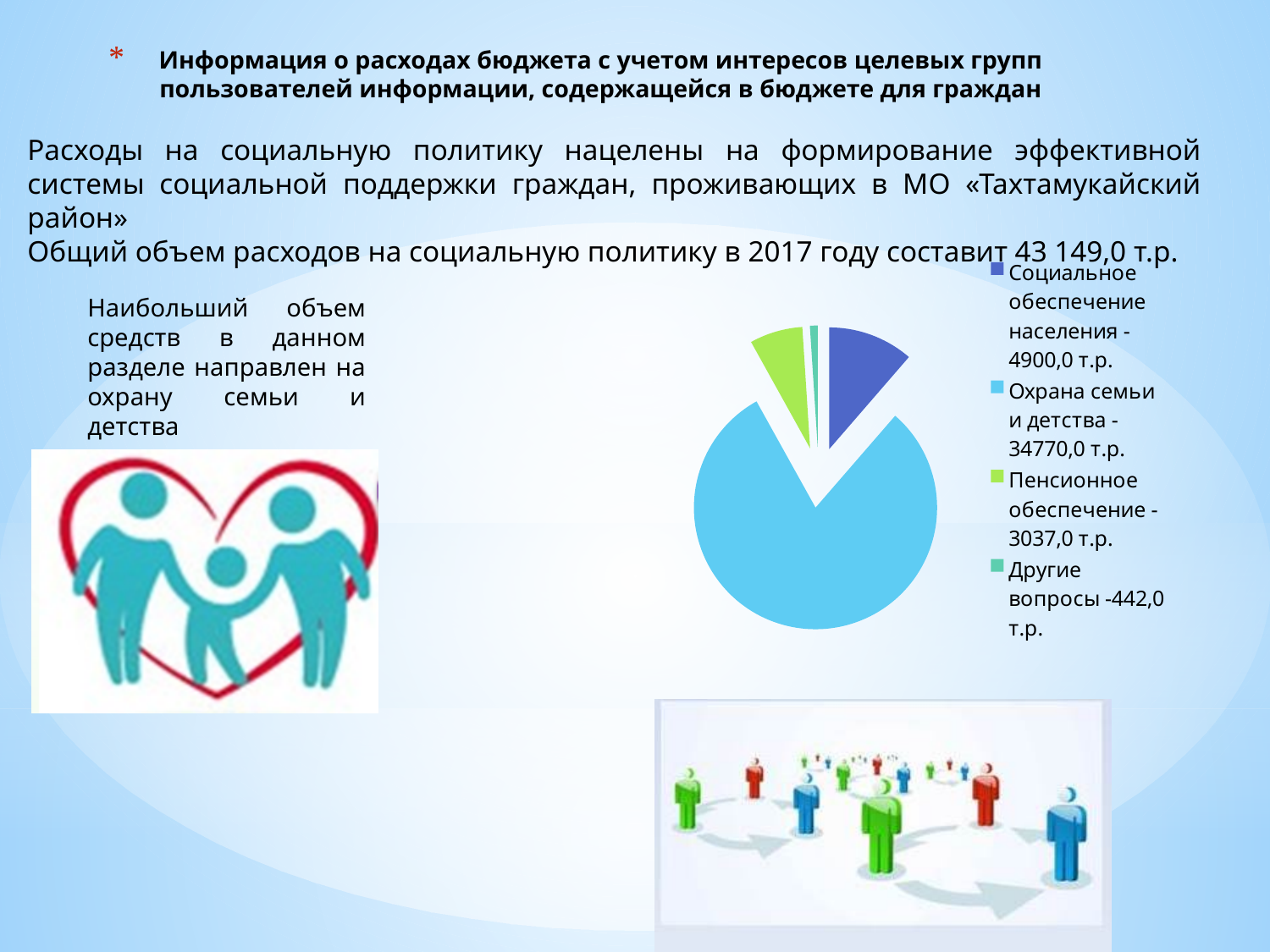
Which category has the largest slice in the pie chart? Охрана семьи и детства Which category has the smallest slice in the pie chart? Другие вопросы What is the value for Пенсионное обеспечение in the pie chart? 3037,0 т.р. Which is larger in the pie chart: Социальное обеспечение населения or Пенсионное обеспечение? Социальное обеспечение населения What is the total of all four categories in the pie chart? 43 149,0 т.р. What is the value for Социальное обеспечение населения in the pie chart? 4900,0 т.р. What kind of chart is shown on the slide? pie chart What is the value for Охрана семьи и детства in the pie chart? 34770,0 т.р. What is the difference between Охрана семьи и детства and Социальное обеспечение населения in the pie chart? 29870,0 т.р. What colour is the largest slice of the pie chart? light blue How many categories does the pie chart show? 4 What is the value for Другие вопросы in the pie chart? 442,0 т.р.